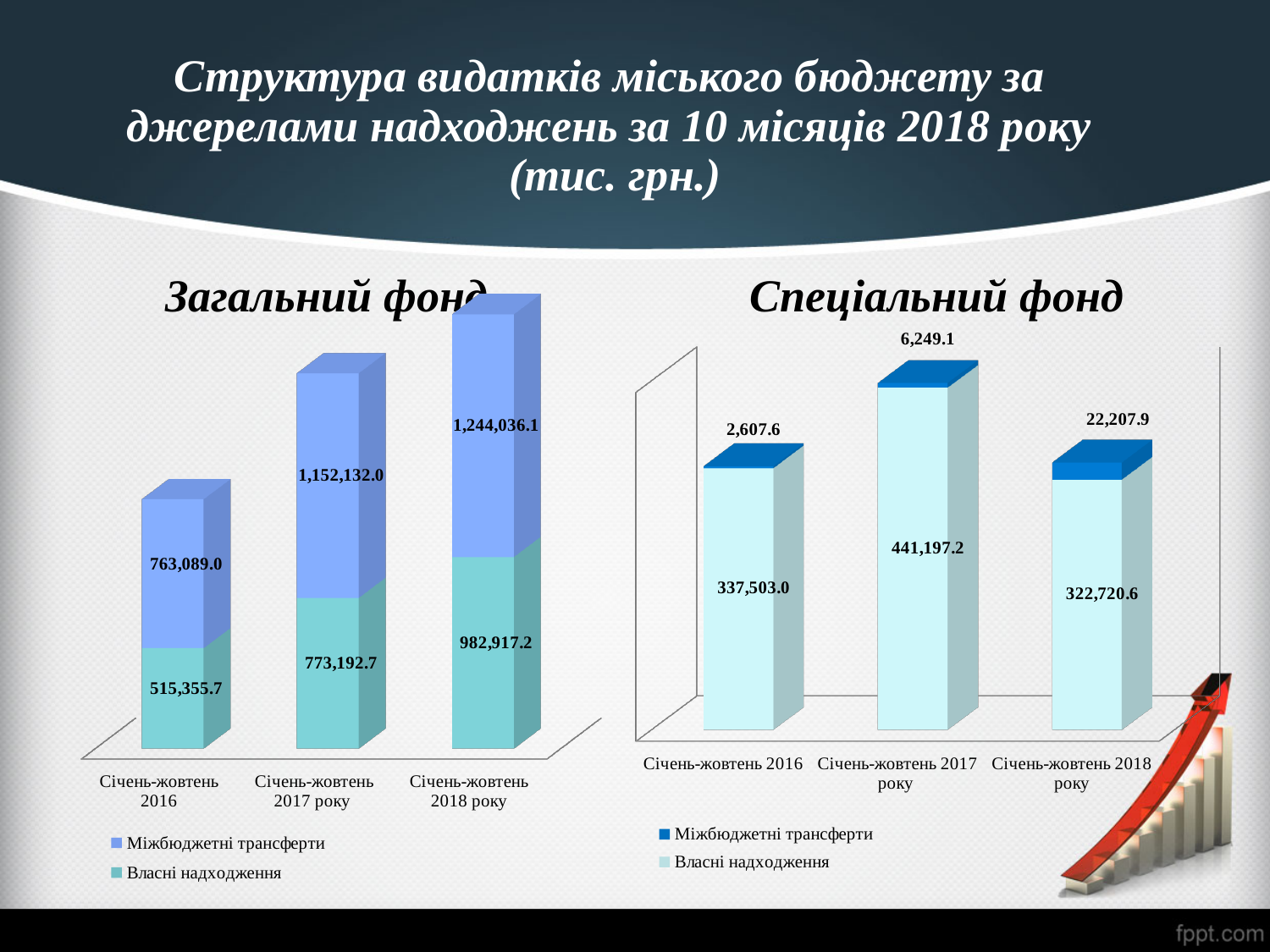
In the Спеціальний фонд chart, which period has the highest value of Власні надходження? Січень-жовтень 2017 року In the Спеціальний фонд chart, what is the value of Власні надходження for Січень-жовтень 2017 року? 441,197.2 In the Загальний фонд chart, what is the difference in Власні надходження between Січень-жовтень 2018 року and Січень-жовтень 2017 року? 209,724.5 In the Спеціальний фонд chart, what is the value of Міжбюджетні трансферти for Січень-жовтень 2018 року? 22,207.9 How many series does the legend of the Загальний фонд chart list? 2 In the Загальний фонд chart, which period has the lowest value of Міжбюджетні трансферти? Січень-жовтень 2016 In the Спеціальний фонд chart, is Власні надходження larger for Січень-жовтень 2016 or Січень-жовтень 2018 року? Січень-жовтень 2016 In the Спеціальний фонд chart, what is the total of the stacked bar for Січень-жовтень 2016? 340,110.6 What kind of chart is the Спеціальний фонд chart? Stacked bar chart In the Загальний фонд chart, what is the total of the stacked bar for Січень-жовтень 2017 року? 1,925,324.7 In the Загальний фонд chart, what is the value of Міжбюджетні трансферти for Січень-жовтень 2018 року? 1,244,036.1 In the Загальний фонд chart, what is the value of Власні надходження for Січень-жовтень 2016? 515,355.7